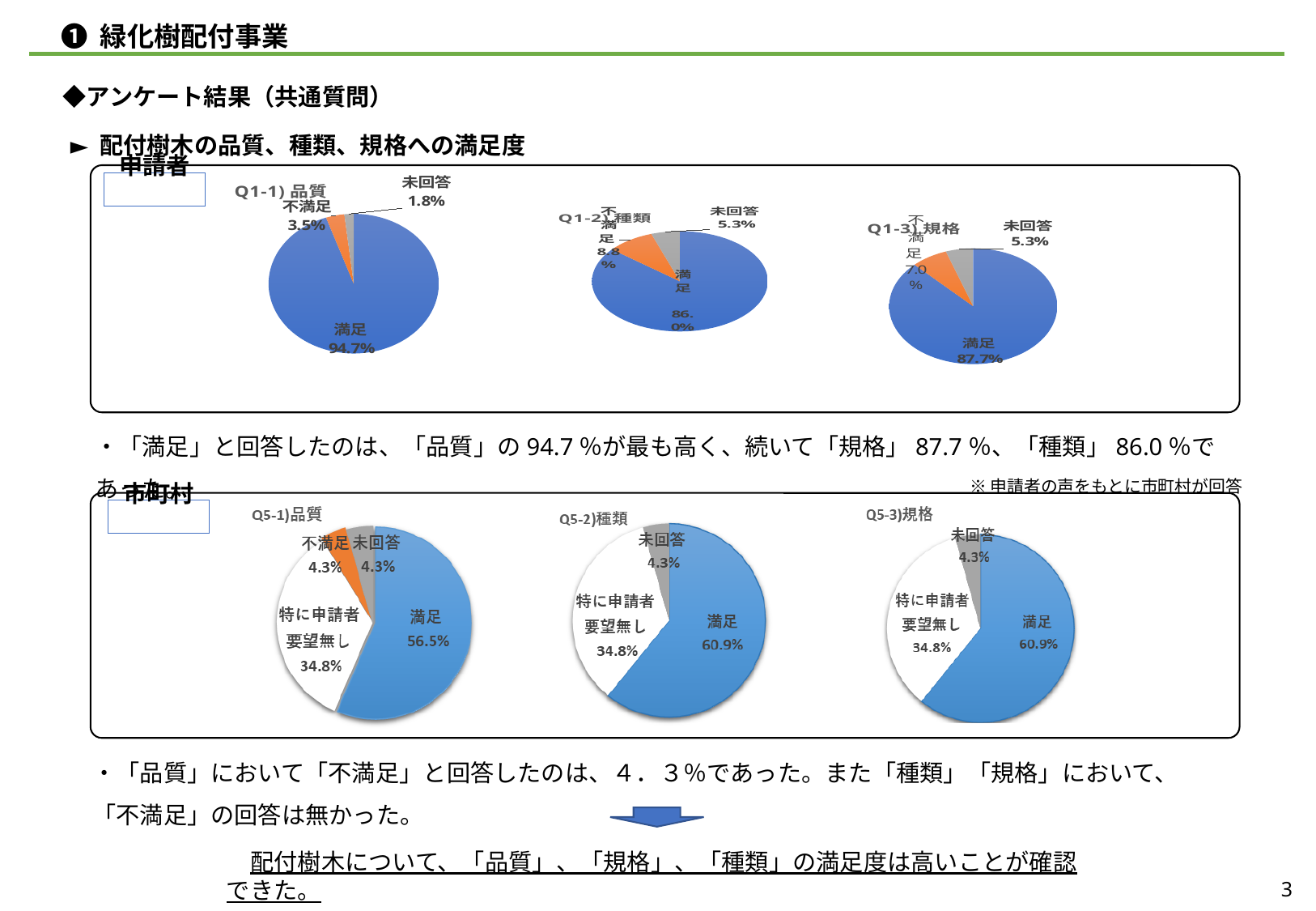
What is the difference between the 満足 share in the Q1-1) 品質 chart and the 満足 share in the Q1-3) 規格 chart? 7.0% In the Q5-1)品質 pie chart, what percentage of respondents answered 特に申請者要望無し? 34.8% How many categories are shown in the Q5-1)品質 pie chart? 4 What type of chart is used for Q1-1) 品質? Pie chart In the Q5-1)品質 pie chart, which category has the largest share? 満足 In the Q1-1) 品質 pie chart, which category has the largest share? 満足 In the Q5-2)種類 pie chart, what percentage of respondents answered 満足? 60.9% Which is larger: the 満足 share in the Q5-1)品質 chart or the 満足 share in the Q5-3)規格 chart? Q5-3)規格 In the Q1-2) 種類 pie chart, what percentage of respondents answered 不満足? 8.8% In the Q1-2) 種類 pie chart, which category has the smallest share? 未回答 In the Q1-1) 品質 pie chart, what percentage of respondents answered 満足? 94.7% In the Q1-3) 規格 pie chart, what percentage of respondents answered 未回答? 5.3%